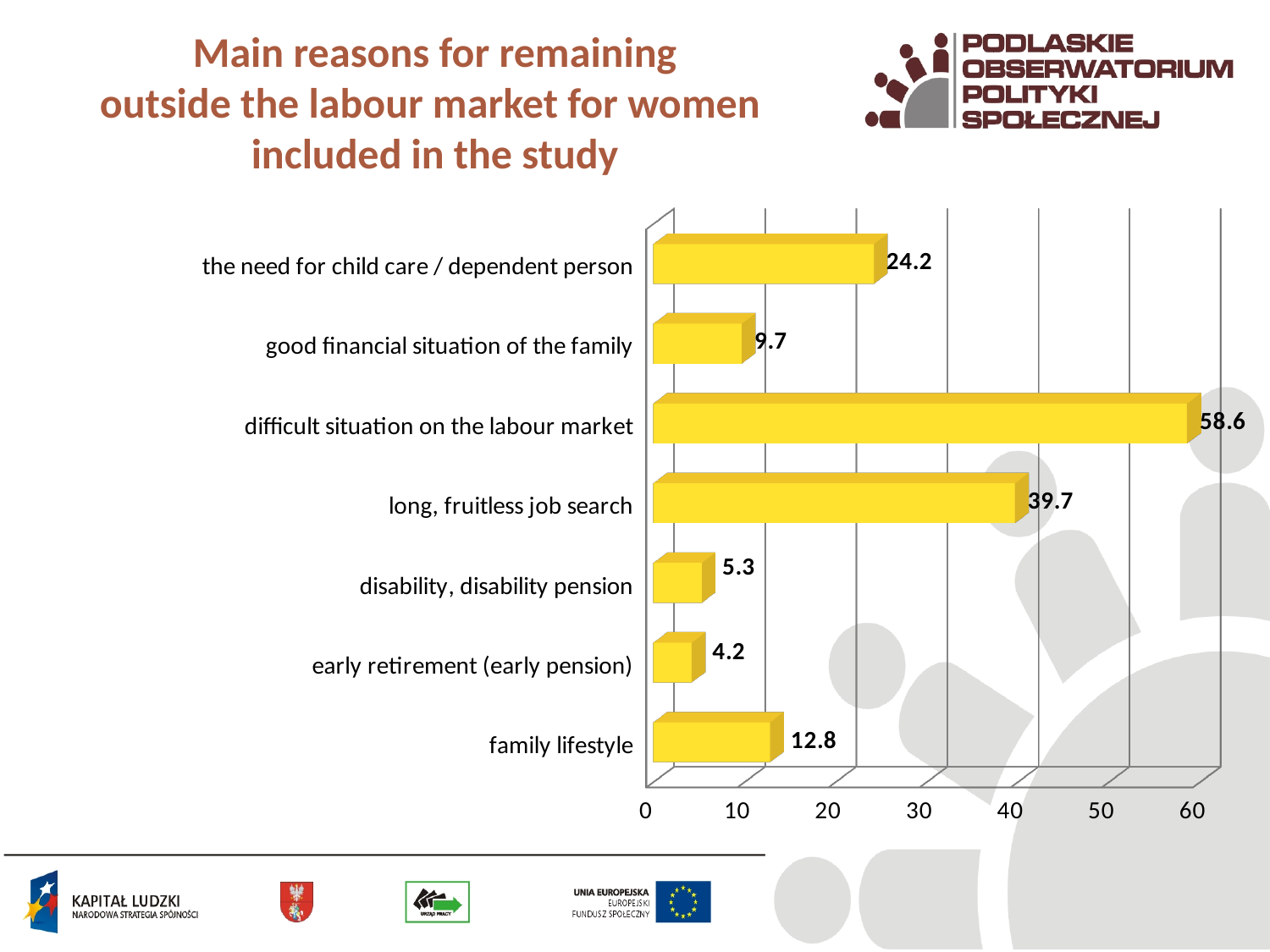
What is the difference between 'difficult situation on the labour market' and 'long, fruitless job search'? 18.9 What is the value for 'the need for child care / dependent person'? 24.2 Which category has the highest value? difficult situation on the labour market Which category has the lowest value? early retirement (early pension) What is the value for 'early retirement (early pension)'? 4.2 Is the value for 'long, fruitless job search' greater or less than 30? greater What is the difference between 'family lifestyle' and 'good financial situation of the family'? 3.1 What is the title of the slide? Main reasons for remaining outside the labour market for women included in the study What is the value for 'difficult situation on the labour market'? 58.6 How many categories are shown in the chart? 7 What kind of chart is shown on the slide? bar chart Which is larger: 'the need for child care / dependent person' or 'family lifestyle'? the need for child care / dependent person